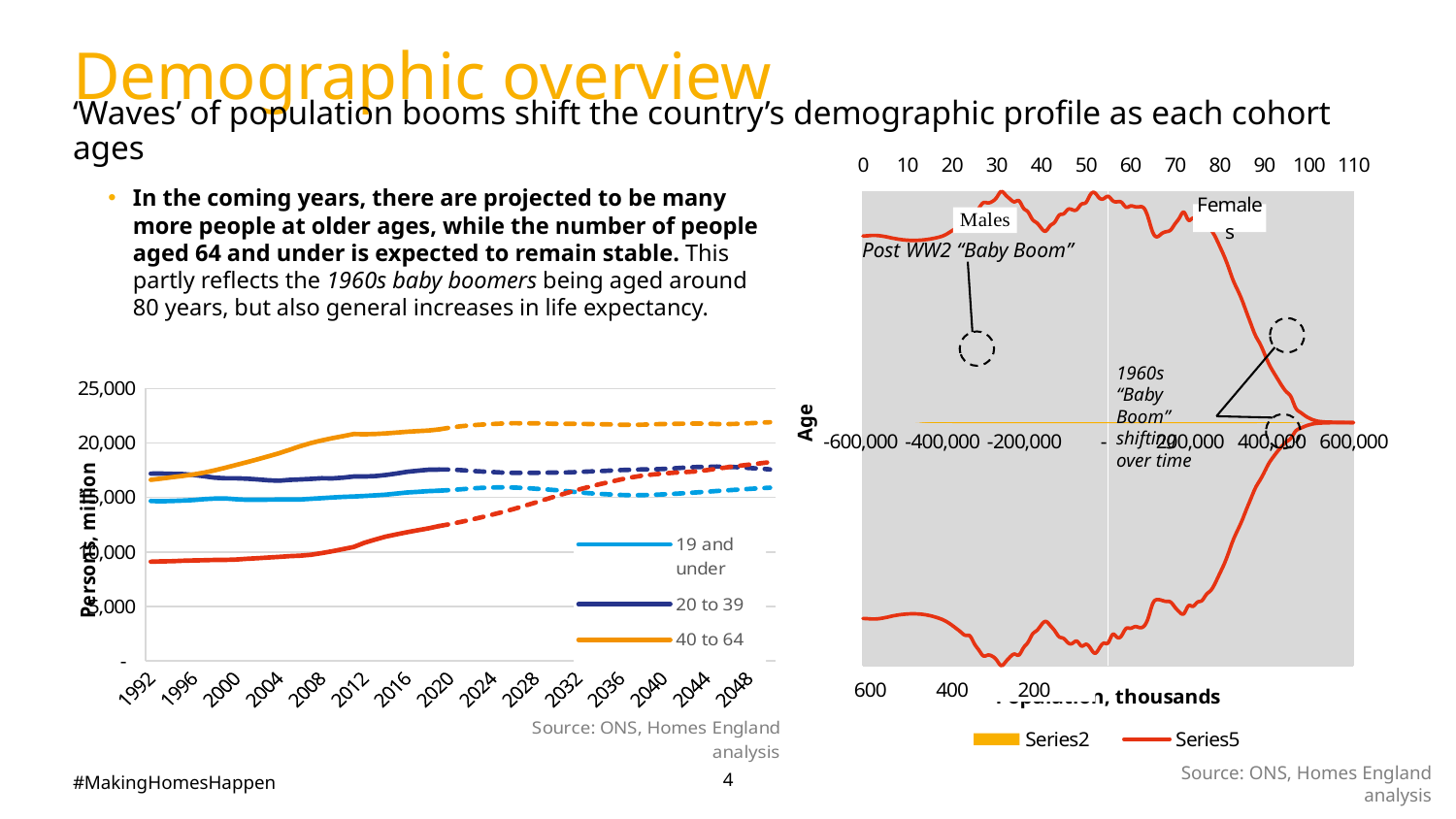
What is the y-axis label of the right chart? Age On the left chart, which is larger in 2020: 40 to 64 or 20 to 39? 40 to 64 How many series does the legend of the right chart list? 2 What is the y-axis label of the left chart? Persons, million On the left chart, which series has the highest value in 2048? 40 to 64 How many series does the legend of the left chart list? 3 On the left chart, does the 40 to 64 series rise or fall between 1992 and 2020? rise On the left chart, is the value for 40 to 64 in 2020 greater or less than 20,000? greater What is the source given below the left chart? ONS, Homes England analysis On the left chart, is the value for 40 to 64 in 1992 greater or less than 20,000? less How many year labels are shown on the x axis of the left chart? 15 What kind of chart is the left chart showing persons in millions by year? line chart